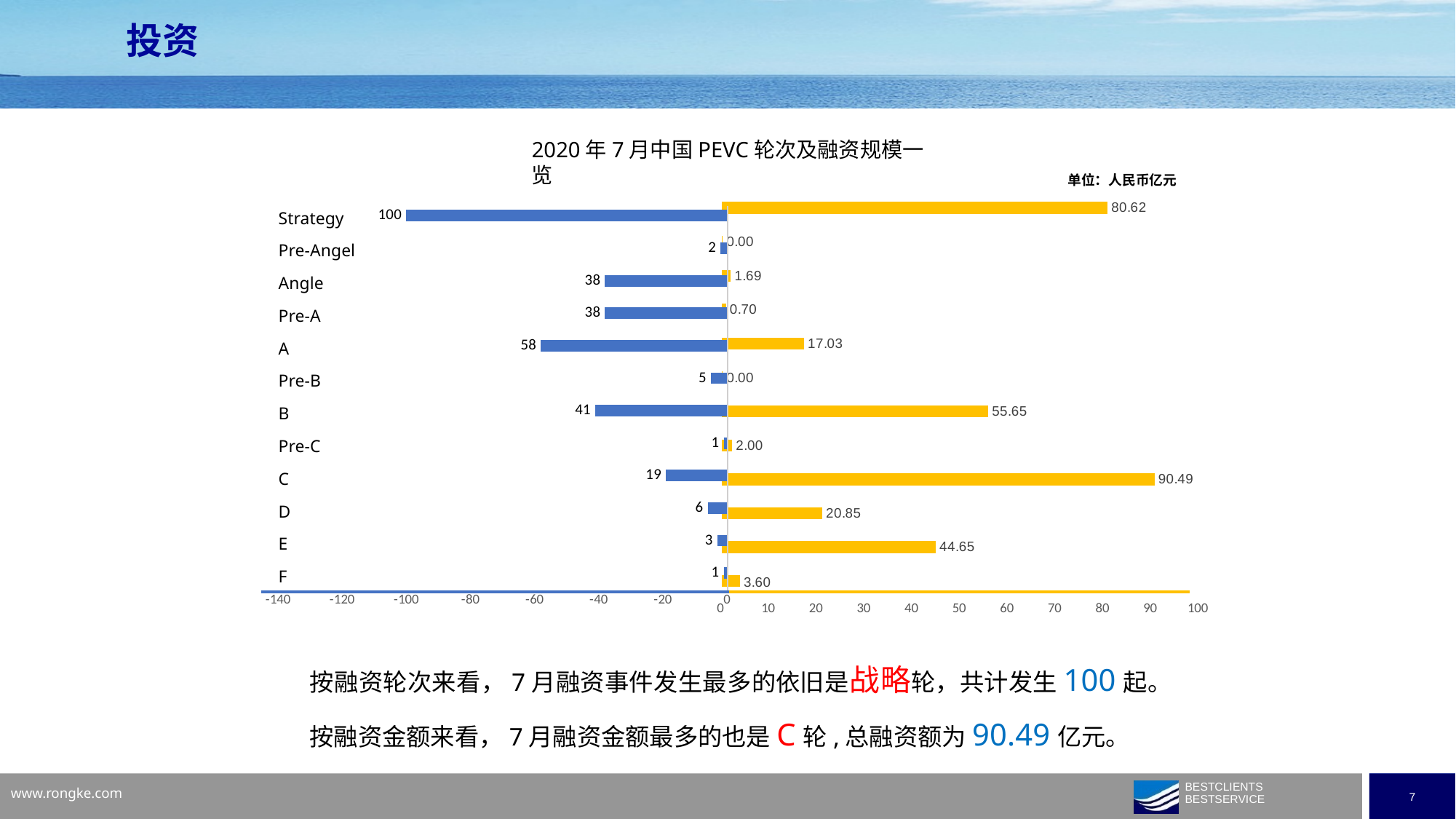
What is the financing amount (yellow bar) for round B? 55.65 What is the difference between the financing amounts of round C and round B? 34.84 How many rounds (categories) are shown on the chart? 12 Which has a larger financing amount, round E or round D? E How many financing events (blue bar) are shown for round A? 58 How many financing events (blue bar) are shown for the Strategy round? 100 Which round has the largest number of financing events (blue bar)? Strategy What type of chart is shown on the slide? Bar chart What is the financing amount (yellow bar) for round C? 90.49 Which round has the highest financing amount (yellow bar)? C What is the difference in the number of financing events between round A and round B? 17 What unit is stated for the financing amounts on the chart? 人民币亿元